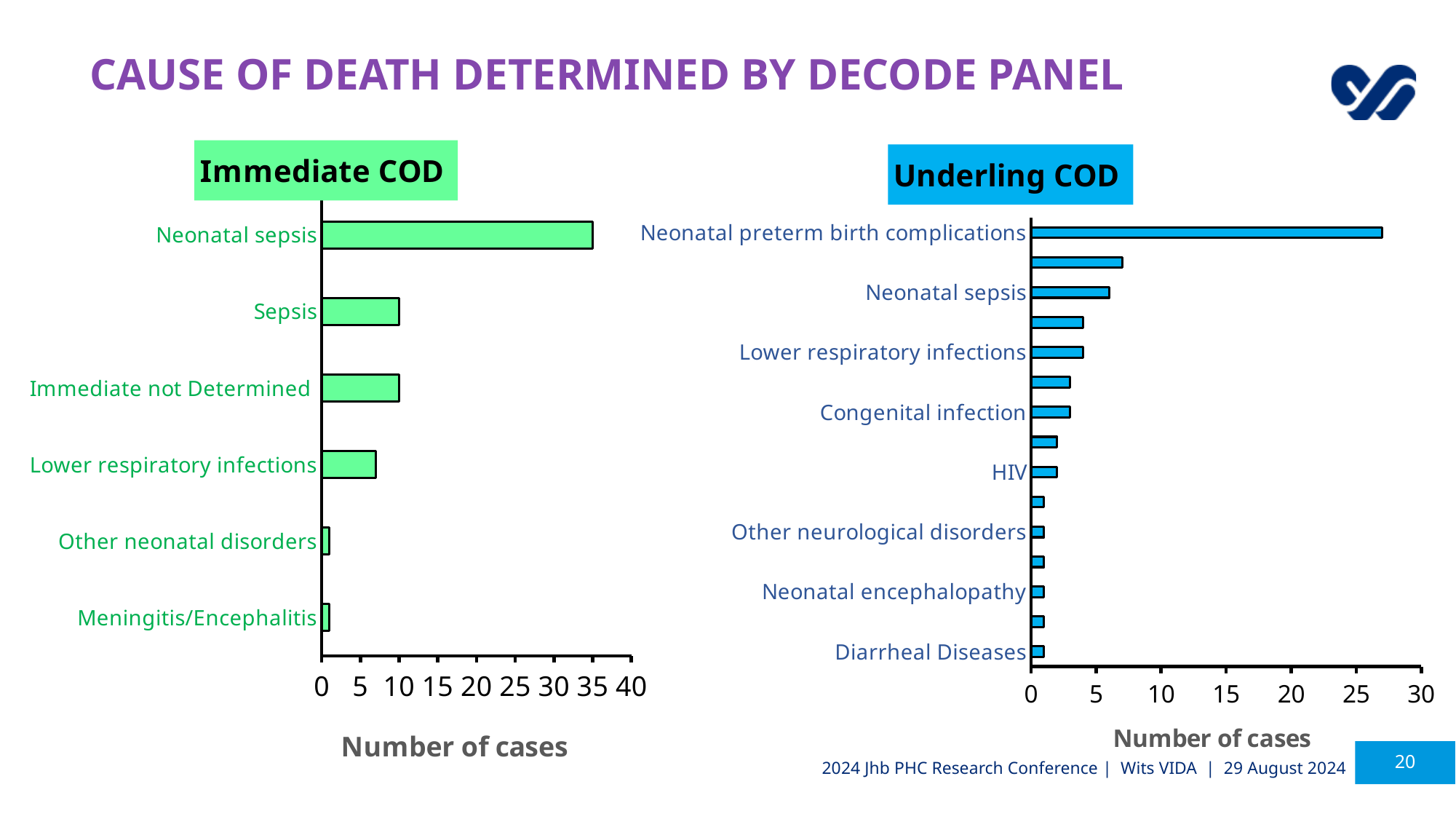
In the Immediate COD chart, what is the number of cases for Sepsis? 10 In the Immediate COD chart, which cause has the highest number of cases? Neonatal sepsis In the Immediate COD chart, is the value for Lower respiratory infections greater or less than 10? less What kind of chart is the Immediate COD chart? bar chart What is the x-axis title of the Underling COD chart? Number of cases How many categories are shown in the Immediate COD chart? 6 In the Underling COD chart, which cause has the highest number of cases? Neonatal preterm birth complications In the Underling COD chart, is the value for Neonatal sepsis greater or less than 10? less In the Underling COD chart, which has more cases: Neonatal sepsis or HIV? Neonatal sepsis In the Immediate COD chart, which has more cases: Sepsis or Lower respiratory infections? Sepsis In the Immediate COD chart, is the value for Neonatal sepsis greater or less than 30? greater